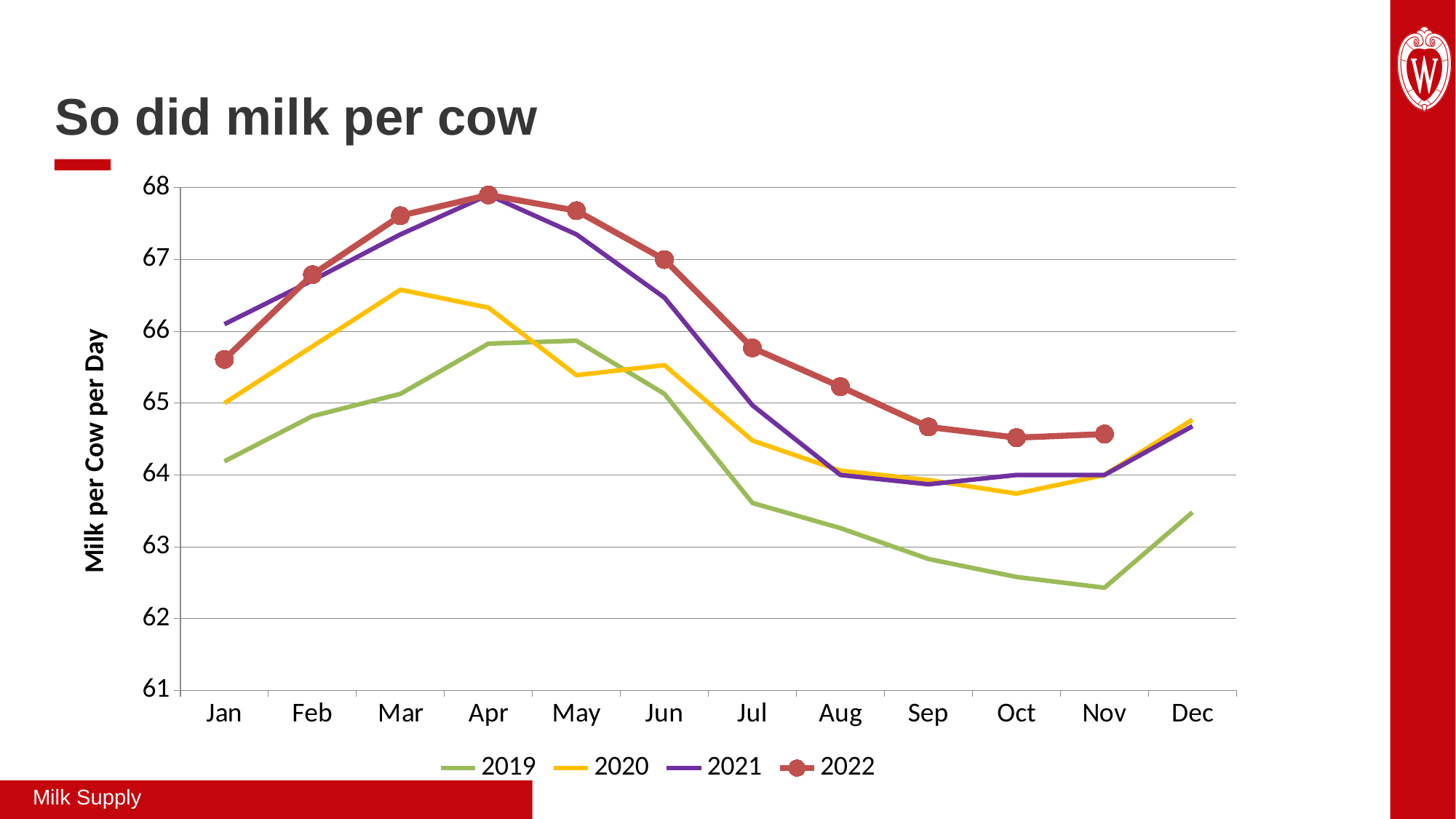
In which month does the 2019 series reach its lowest value? Nov What kind of chart is shown on the slide? line chart How many series does the legend list? 4 Is the value for 2022 in Jan greater or less than 65? greater Is the value for 2019 in Nov greater or less than 63? less Does the 2022 series rise or fall from Apr to Oct? fall Is the value for 2019 in Jul greater or less than 64? less In which month does the 2022 series reach its highest value? Apr Which series has the larger value in Jan, 2022 or 2019? 2022 How many months are shown along the x axis? 12 What is the label on the vertical axis? Milk per Cow per Day In which month does the 2020 series reach its highest value? Mar